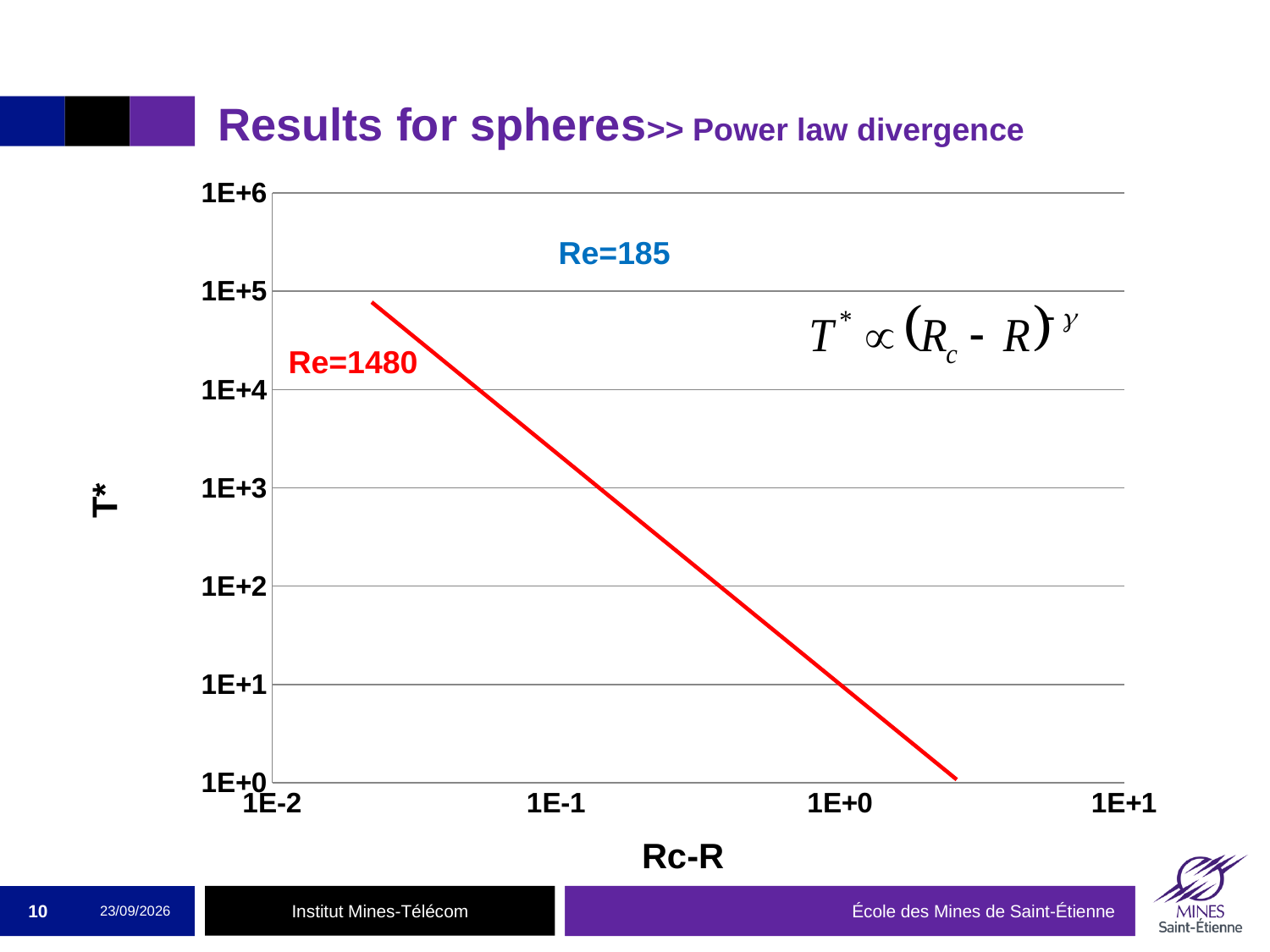
What is the label on the y axis of the chart? T* At Rc-R = 1E+0, is the value of T* on the red line greater or less than 1E+2? less What is the lowest tick value shown on the y axis? 1E+0 At Rc-R = 1E-1, is the value of T* on the red line greater or less than 1E+4? less What is the highest tick value shown on the y axis? 1E+6 How many tick labels are shown on the x axis? 4 What kind of chart is shown on the slide? line chart Which Reynolds number label is written in red next to the plotted line? Re=1480 At Rc-R = 1E-1, is the value of T* on the red line greater or less than 1E+2? greater How many lines are plotted on the chart? 1 Does the plotted line rise or fall as Rc-R increases along the x axis? fall What is the label on the x axis of the chart? Rc-R